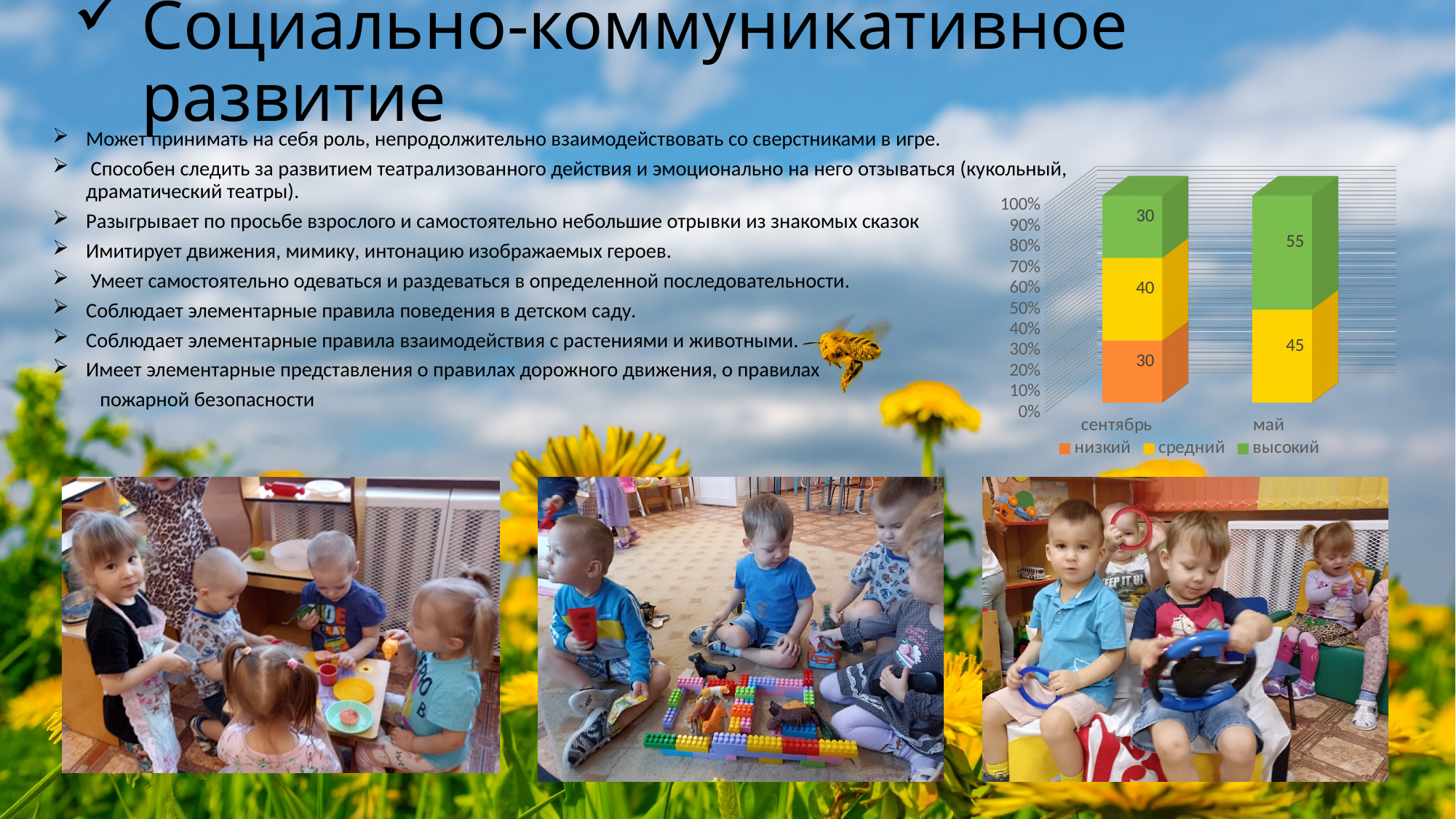
How many categories are shown on the x axis? 2 Which series has the largest value in май? высокий What kind of chart is shown on the slide? stacked bar chart What is the difference between the высокий values for май and сентябрь? 25 What is the value for средний in май? 45 Which colour represents the series высокий in the legend? green How many series does the legend list? 3 Which is larger: средний in сентябрь or средний in май? средний in май What is the value for средний in сентябрь? 40 What is the value for высокий in май? 55 Which series has the largest value in сентябрь? средний What is the value for низкий in сентябрь? 30